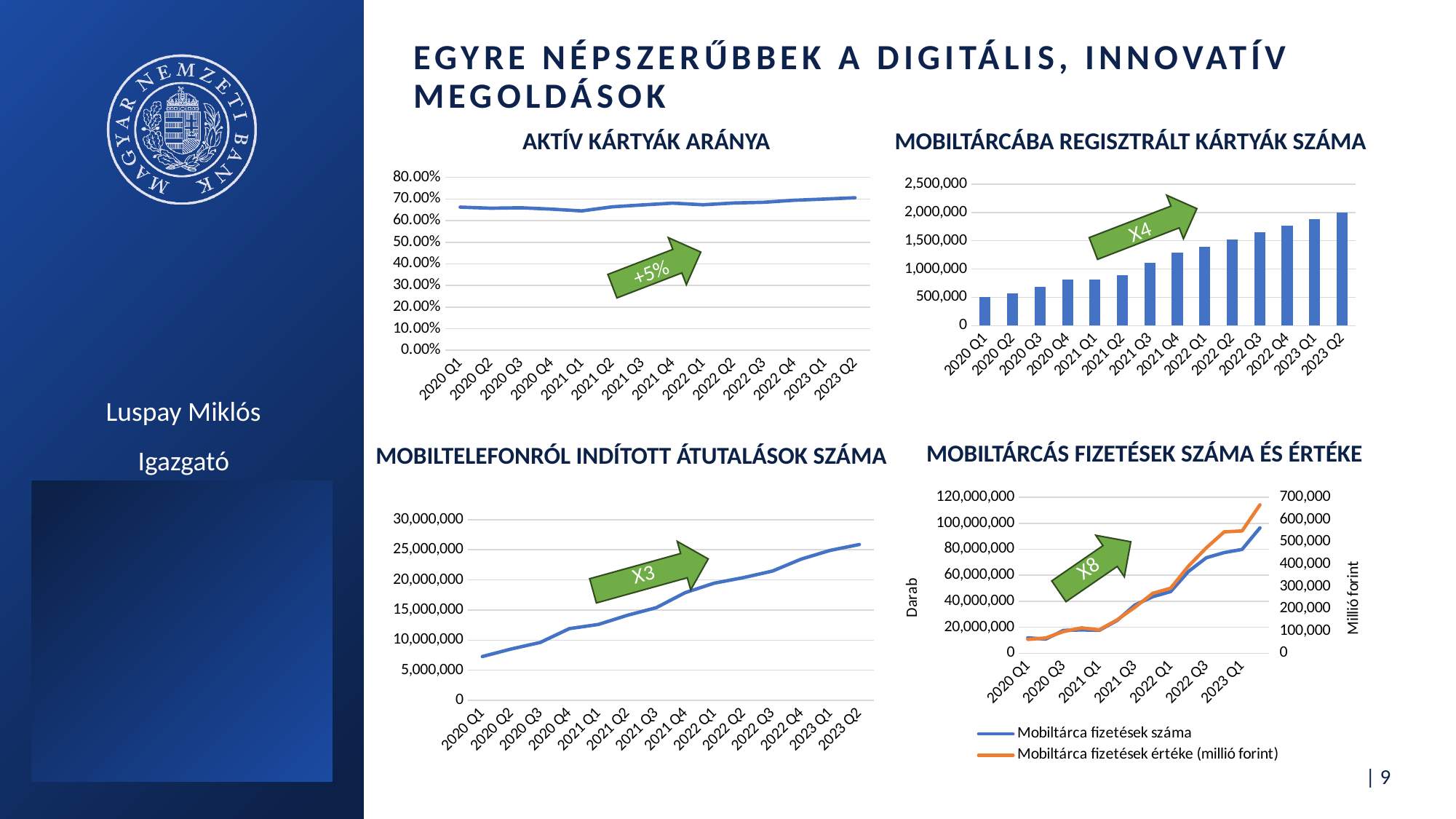
In the "MOBILTELEFONRÓL INDÍTOTT ÁTUTALÁSOK SZÁMA" chart, do the values rise or fall from 2020 Q1 to 2023 Q2? rise In the "MOBILTÁRCÁBA REGISZTRÁLT KÁRTYÁK SZÁMA" chart, is the value for 2022 Q1 greater or less than 1,000,000? greater How many series does the legend of the "MOBILTÁRCÁS FIZETÉSEK SZÁMA ÉS ÉRTÉKE" chart list? 2 What type of chart is the "AKTÍV KÁRTYÁK ARÁNYA" chart? line chart In the "MOBILTÁRCÁS FIZETÉSEK SZÁMA ÉS ÉRTÉKE" chart, which series is drawn in orange? Mobiltárca fizetések értéke (millió forint) How many quarters are shown on the x axis of the "MOBILTELEFONRÓL INDÍTOTT ÁTUTALÁSOK SZÁMA" chart? 14 In the "MOBILTÁRCÁBA REGISZTRÁLT KÁRTYÁK SZÁMA" chart, which quarter has the highest value? 2023 Q2 In the "AKTÍV KÁRTYÁK ARÁNYA" chart, is the value for 2020 Q1 greater or less than 60.00%? greater What type of chart is the "MOBILTÁRCÁBA REGISZTRÁLT KÁRTYÁK SZÁMA" chart? bar chart In the "MOBILTÁRCÁBA REGISZTRÁLT KÁRTYÁK SZÁMA" chart, which quarter has the lowest value? 2020 Q1 In the "MOBILTELEFONRÓL INDÍTOTT ÁTUTALÁSOK SZÁMA" chart, is the value for 2021 Q4 greater or less than 20,000,000? less What is the label of the right-hand vertical axis in the "MOBILTÁRCÁS FIZETÉSEK SZÁMA ÉS ÉRTÉKE" chart? Millió forint